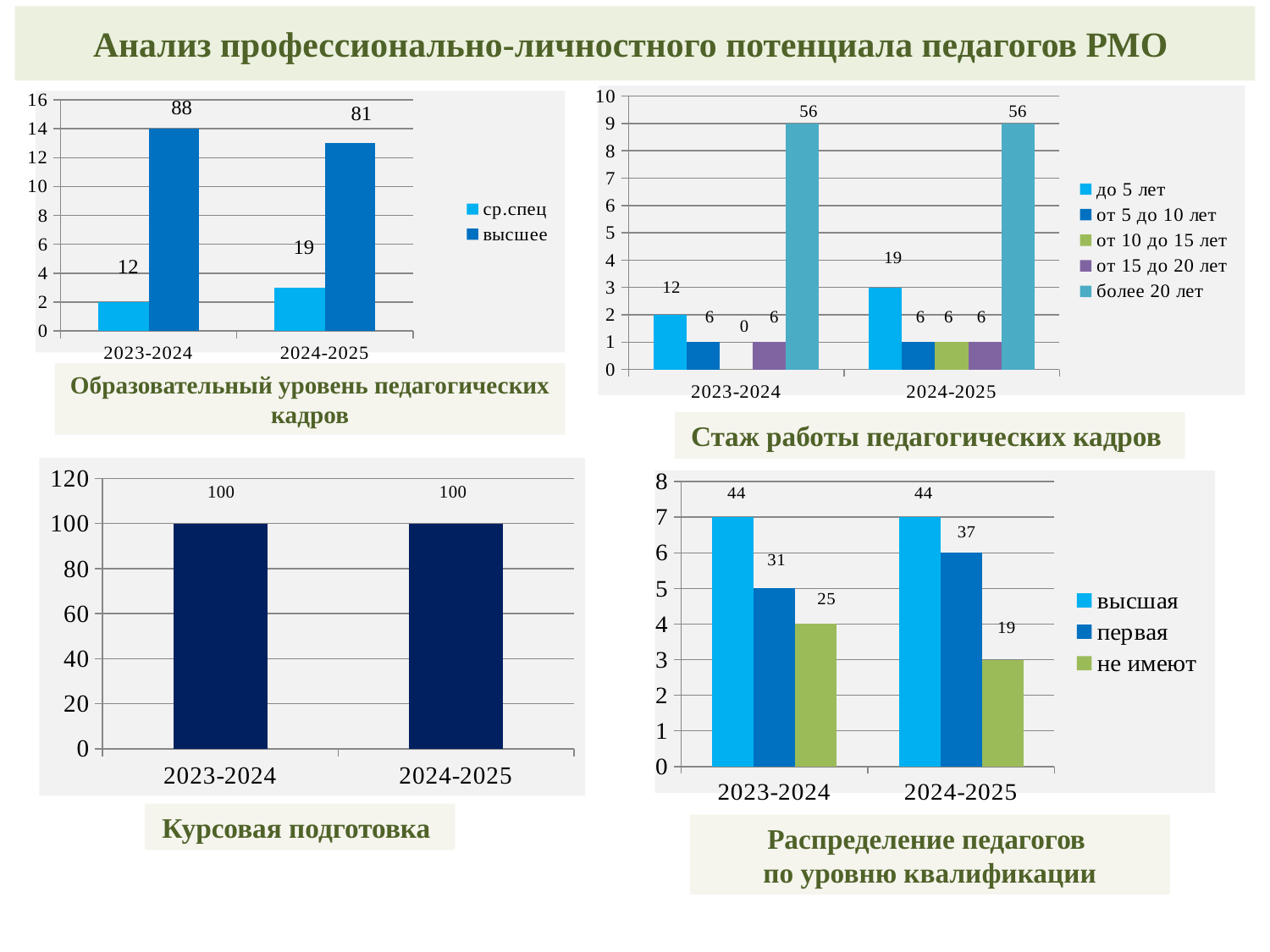
In the chart titled 'Образовательный уровень педагогических кадров', what data label is shown for 'высшее' in 2023-2024? 88 In the chart titled 'Распределение педагогов по уровню квалификации', which series has the lowest bar in 2024-2025? не имеют In the chart titled 'Распределение педагогов по уровню квалификации', what data label is shown for 'первая' in 2024-2025? 37 In the chart titled 'Курсовая подготовка', what data label is shown for 2024-2025? 100 In the chart titled 'Стаж работы педагогических кадров', how many series does the legend list? 5 In the chart titled 'Распределение педагогов по уровню квалификации', what is the difference between the data labels for 'не имеют' in 2023-2024 and 2024-2025? 6 What kind of chart is the one titled 'Курсовая подготовка'? bar chart In the chart titled 'Стаж работы педагогических кадров', what data label is shown for 'более 20 лет' in 2024-2025? 56 In the chart titled 'Образовательный уровень педагогических кадров', what data label is shown for 'ср.спец' in 2024-2025? 19 In the chart titled 'Образовательный уровень педагогических кадров', how many series does the legend list? 2 In the chart titled 'Стаж работы педагогических кадров', which series has the tallest bar in 2023-2024? более 20 лет In the chart titled 'Стаж работы педагогических кадров', what data label is shown for 'от 10 до 15 лет' in 2023-2024? 0